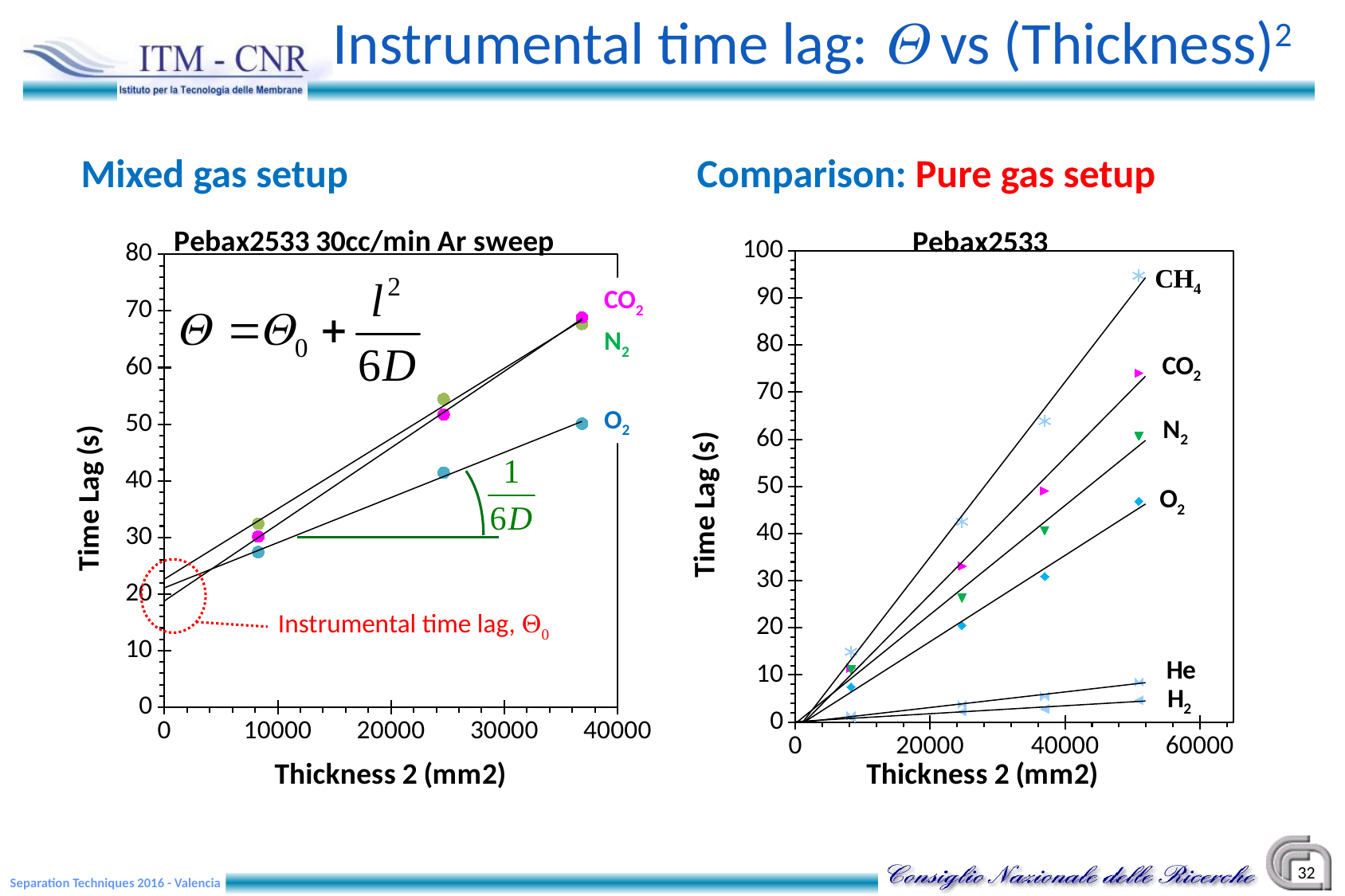
How many gas series are labelled on the right chart (Pebax2533)? 6 On the right chart (Pebax2533), which has the larger time lag at the largest thickness squared, CO2 or N2? CO2 On the right chart (Pebax2533), is the He time lag at the largest thickness squared greater or less than 10 s? less What type of chart is the left chart titled 'Pebax2533 30cc/min Ar sweep'? scatter chart On the right chart (Pebax2533), which gas has the lowest time lag at the largest thickness squared? H2 How many gas series are labelled on the left chart (Pebax2533 30cc/min Ar sweep)? 3 On the left chart (Pebax2533 30cc/min Ar sweep), is the CO2 time lag at the largest thickness squared greater or less than 60 s? greater On the right chart (Pebax2533), which gas has the highest time lag at the largest thickness squared? CH4 On the left chart (Pebax2533 30cc/min Ar sweep), does the time lag rise or fall as thickness squared increases? rise On the left chart (Pebax2533 30cc/min Ar sweep), which gas has the lowest time lag at the largest thickness squared? O2 On the left chart (Pebax2533 30cc/min Ar sweep), is the O2 time lag at about 25000 mm2 greater or less than 30 s? greater